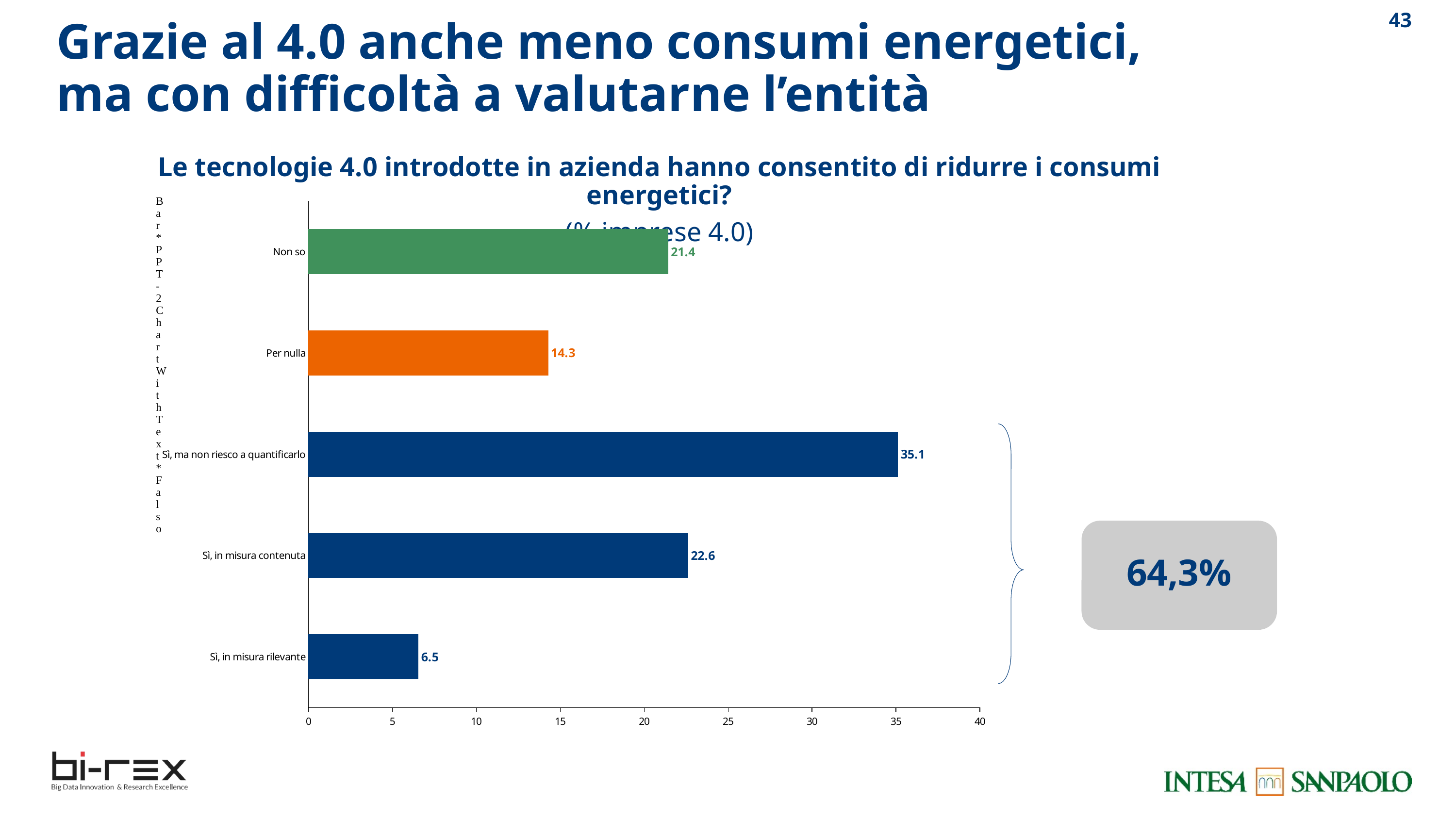
What percentage is shown in the grey box next to the bracket grouping the three "Sì" bars? 64,3% What kind of chart is shown on the slide? Bar chart Which category has the lowest value? Sì, in misura rilevante What is the value for "Per nulla"? 14.3 What is the value for "Sì, ma non riesco a quantificarlo"? 35.1 What is the difference between the values for "Sì, in misura contenuta" and "Per nulla"? 8.3 How many categories are shown in the chart? 5 Which category has the highest value? Sì, ma non riesco a quantificarlo Which is larger, the value for "Non so" or the value for "Sì, in misura contenuta"? Sì, in misura contenuta Is the value for "Sì, ma non riesco a quantificarlo" greater or less than 30? greater What is the value for "Sì, in misura rilevante"? 6.5 What is the value for "Non so"? 21.4